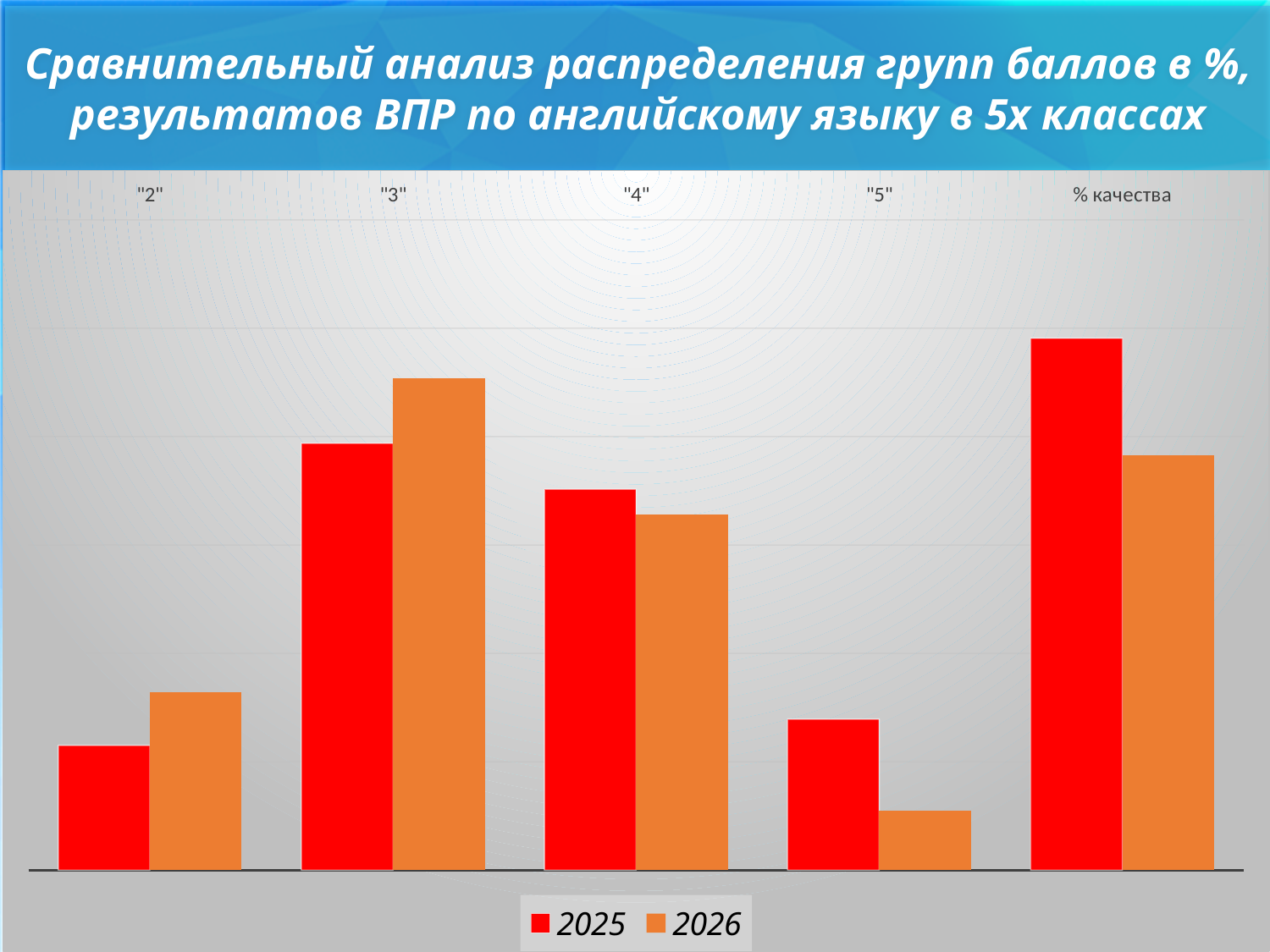
Which category has the lowest value for the 2026 series? "5" Which category has the highest value for the 2026 series? "3" What kind of chart is shown on the slide? bar chart How many categories are shown along the x axis? 5 For the category "5", which series has the larger value, 2025 or 2026? 2025 How many series does the legend list? 2 Which category has the lowest value for the 2025 series? "2" For the category "% качества", which series has the larger value, 2025 or 2026? 2025 For the category "2", which series has the larger value, 2025 or 2026? 2026 Which category has the highest value for the 2025 series? % качества What colour are the bars for the 2026 series? orange